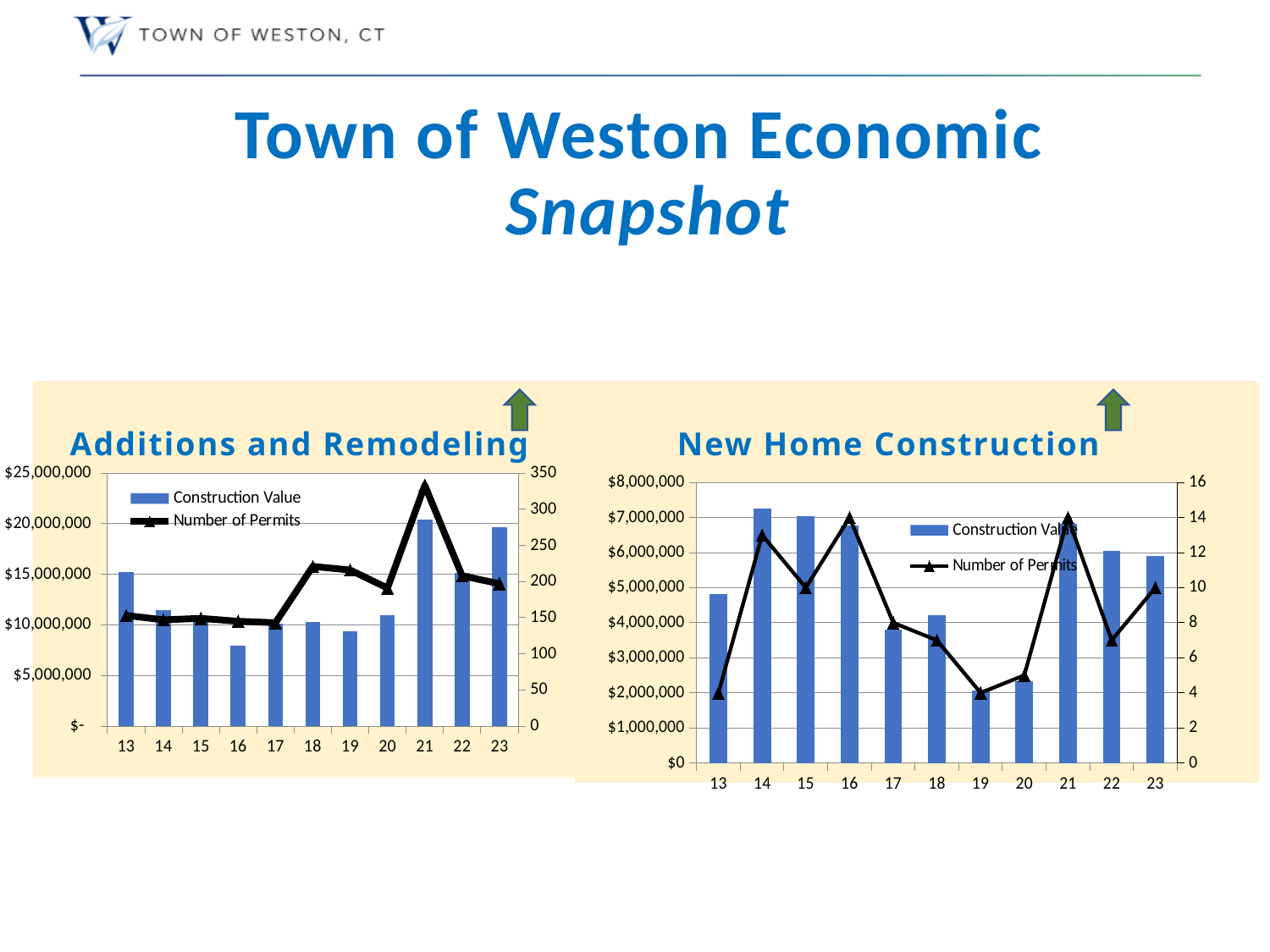
In the Additions and Remodeling chart, which year has the highest Number of Permits? 21 In the Additions and Remodeling chart, does the Number of Permits rise or fall from 20 to 21? rise In the Additions and Remodeling chart, is the Construction Value for 16 greater or less than $10,000,000? less In the Additions and Remodeling chart, is the Number of Permits for 21 greater or less than 300? greater In the Additions and Remodeling chart, how many years are shown on the x axis? 11 In the Additions and Remodeling chart, which year has the highest Construction Value bar? 21 In the New Home Construction chart, is the Construction Value for 22 greater or less than $5,000,000? greater In the Additions and Remodeling chart, which year has the lowest Construction Value bar? 16 How many series does the legend of the New Home Construction chart list? 2 In the New Home Construction chart, which is larger, the Construction Value for 15 or for 19? 15